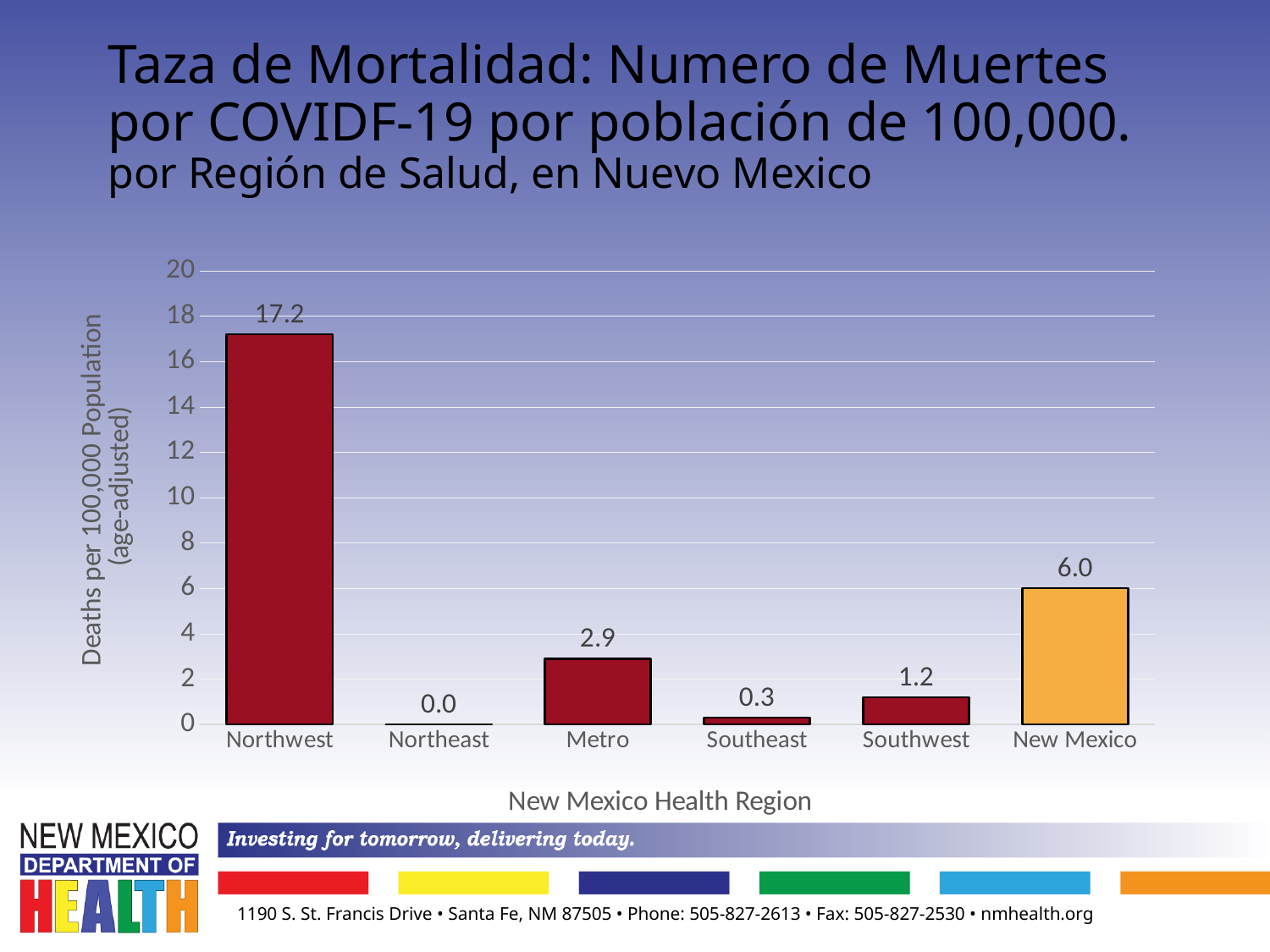
What is the death rate per 100,000 population for the Metro region? 2.9 How many categories are shown on the x axis? 6 Is the value for Northwest greater or less than 16? greater Which region has the highest death rate per 100,000 population? Northwest What is the value shown for the Southwest region? 1.2 What is the death rate per 100,000 population for the Northwest region? 17.2 What is the value shown for New Mexico overall? 6.0 Which region has the lowest death rate per 100,000 population? Northeast What is the label of the x axis? New Mexico Health Region What is the difference between the Northwest value and the New Mexico value? 11.2 Which has a higher death rate, Metro or Southeast? Metro What kind of chart is shown on the slide? Bar chart